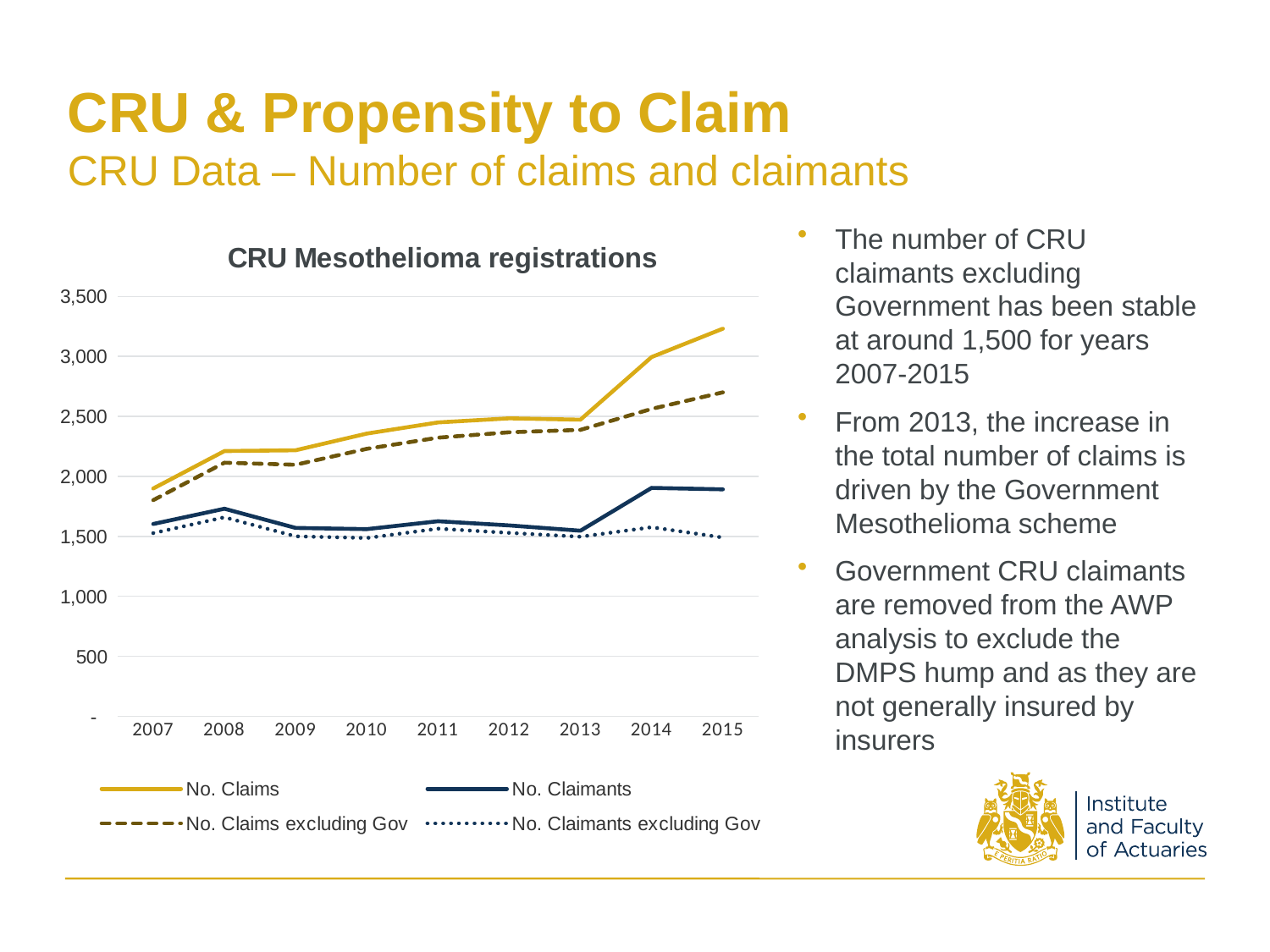
Does No. Claims rise or fall from 2013 to 2015? Rise What kind of chart is the CRU Mesothelioma registrations chart? Line chart In which year is No. Claims excluding Gov highest? 2015 Which series is drawn as a dotted line in the CRU Mesothelioma registrations chart? No. Claimants excluding Gov How many series does the legend of the CRU Mesothelioma registrations chart list? 4 Is the value for No. Claimants in 2014 greater or less than 1,500? greater In 2015, which is larger: No. Claims or No. Claims excluding Gov? No. Claims Is the value for No. Claims in 2015 greater or less than 3,000? greater Is the value for No. Claims in 2007 greater or less than 2,000? less How many years are shown on the x axis of the CRU Mesothelioma registrations chart? 9 In which year is No. Claims highest? 2015 In which year is No. Claims lowest? 2007